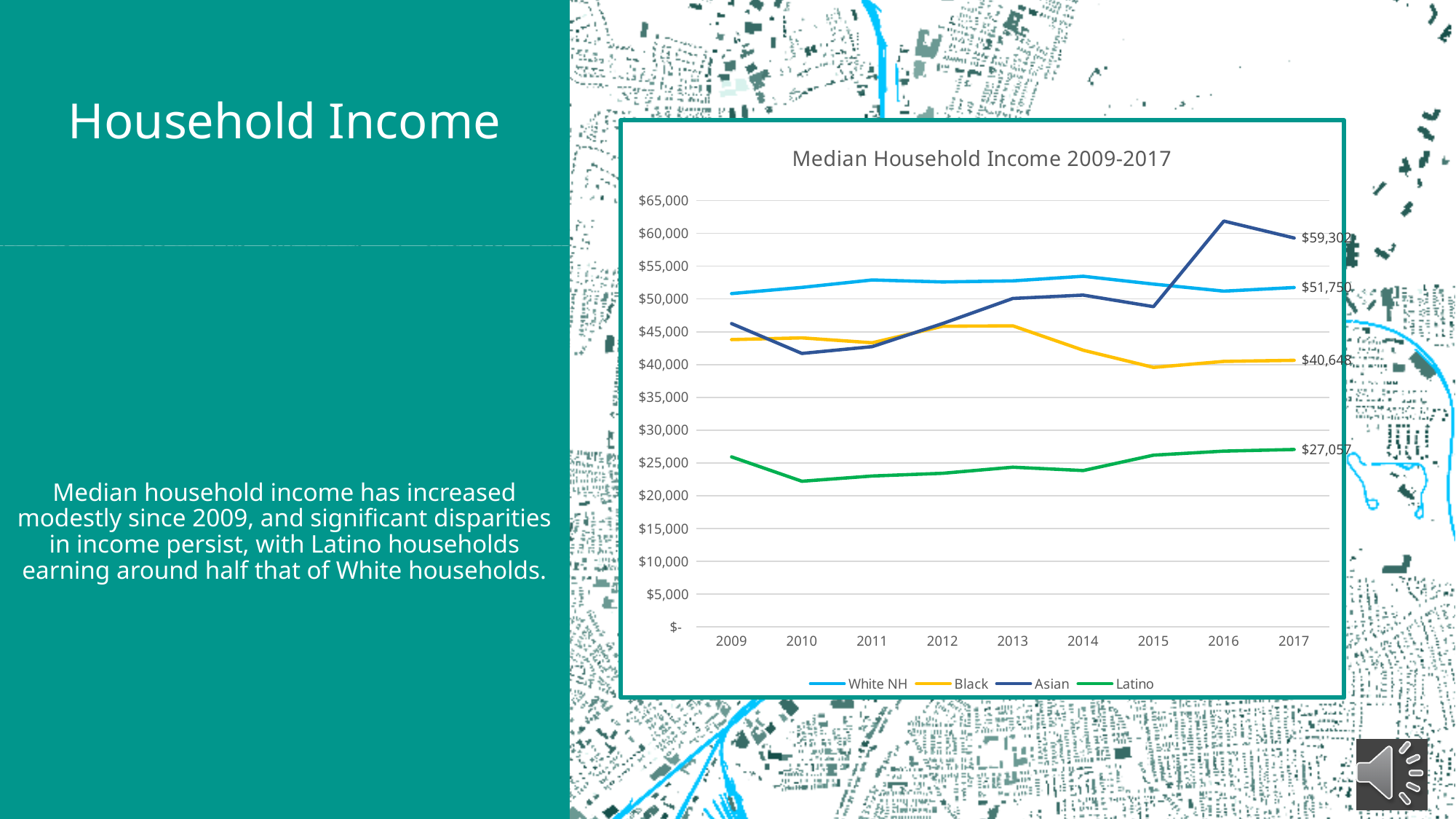
Which group has the highest median household income in 2017? Asian What is the median household income for Asian households in 2017? $59,302 What is the median household income for White NH households in 2017? $51,750 Which group has the lowest median household income in 2017? Latino How many years are plotted along the x axis of the chart? 9 What is the difference between the 2017 median household income of White NH households and Latino households? $24,693 What is the median household income for Latino households in 2017? $27,057 What is the median household income for Black households in 2017? $40,648 What kind of chart is shown on the slide? line chart How many series does the chart legend list? 4 Is the median household income for Latino households in 2010 greater or less than $25,000? less What is the title of the chart? Median Household Income 2009-2017